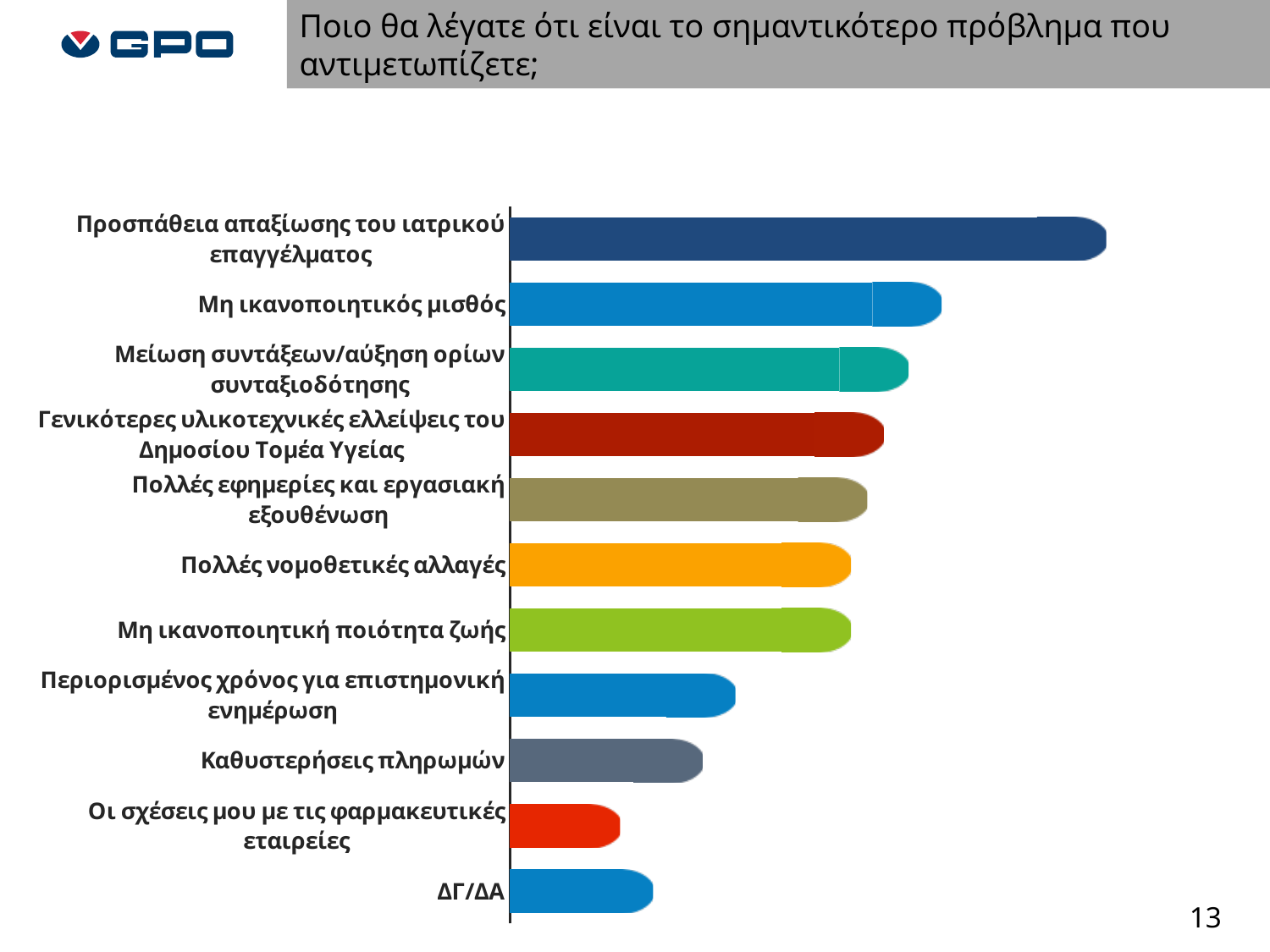
Which category has the longest bar in the chart? Προσπάθεια απαξίωσης του ιατρικού επαγγέλματος What question is shown as the title of the slide above the chart? Ποιο θα λέγατε ότι είναι το σημαντικότερο πρόβλημα που αντιμετωπίζετε; What kind of chart is shown on the slide? Bar chart Which has the larger value: 'ΔΓ/ΔΑ' or 'Καθυστερήσεις πληρωμών'? Καθυστερήσεις πληρωμών Which category has the shortest bar in the chart? Οι σχέσεις μου με τις φαρμακευτικές εταιρείες Are the bars in the chart oriented horizontally or vertically? Horizontally Which has the larger value: 'Μη ικανοποιητικός μισθός' or 'Καθυστερήσεις πληρωμών'? Μη ικανοποιητικός μισθός How many categories (problems) are plotted in the chart? 11 Which has the larger value: 'Προσπάθεια απαξίωσης του ιατρικού επαγγέλματος' or 'Μη ικανοποιητική ποιότητα ζωής'? Προσπάθεια απαξίωσης του ιατρικού επαγγέλματος